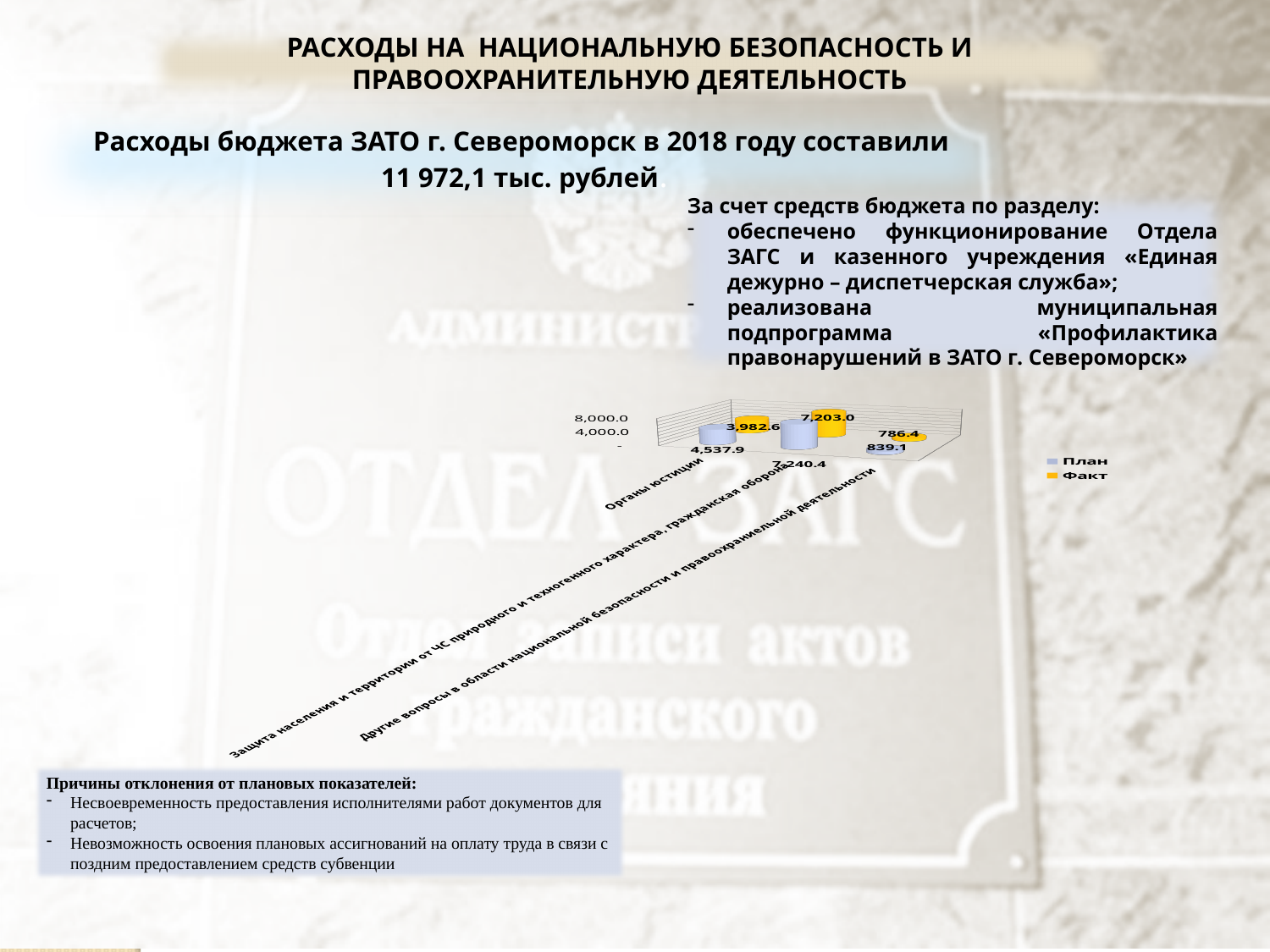
What is the План value for Защита населения и территории от ЧС природного и техногенного характера, гражданская оборона? 7,240.4 For Другие вопросы в области национальной безопасности и правоохранительной деятельности, which is larger: План or Факт? План How many categories are shown on the chart? 3 What is the difference between the План and Факт values for Органы юстиции? 555.3 What kind of chart is shown on the slide? bar chart Which category has the lowest Факт value? Другие вопросы в области национальной безопасности и правоохранительной деятельности How many series does the legend list? 2 Which category has the highest План value? Защита населения и территории от ЧС природного и техногенного характера, гражданская оборона What is the План value for Органы юстиции? 4,537.9 What is the Факт value for Органы юстиции? 3,982.6 What is the Факт value for Другие вопросы в области национальной безопасности и правоохранительной деятельности? 786.4 Is the План value for Органы юстиции greater or less than 4,000.0? greater